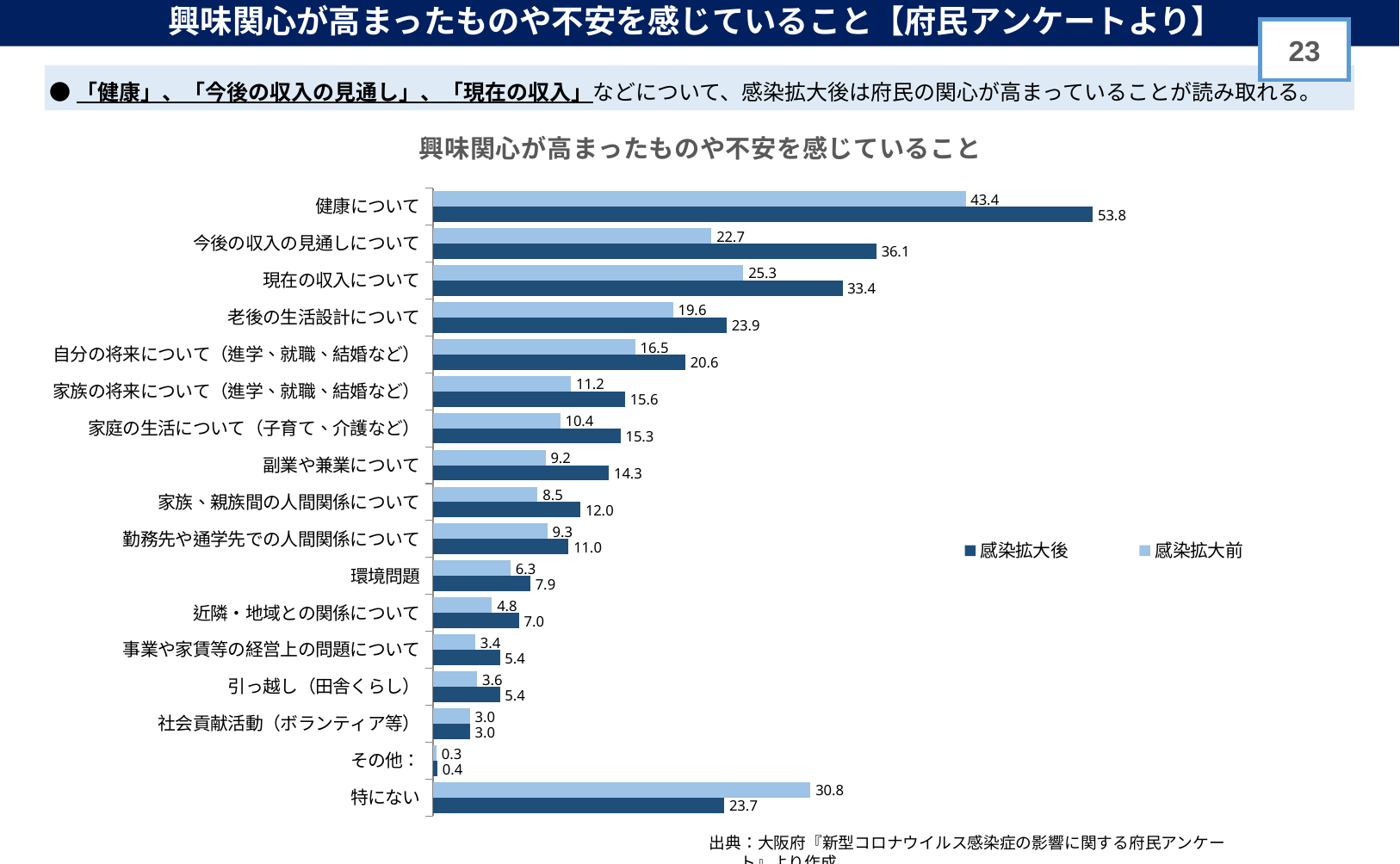
How many series does the legend list? 2 Which category has the lowest value in the 感染拡大前 series? その他： For 特にない, which series has the larger value, 感染拡大後 or 感染拡大前? 感染拡大前 Which series is shown in the darker blue colour? 感染拡大後 What is the value for 今後の収入の見通しについて in the 感染拡大前 series? 22.7 What is the value for 特にない in the 感染拡大前 series? 30.8 How many categories are shown on the chart? 17 What is the difference between the 感染拡大後 and 感染拡大前 values for 健康について? 10.4 What kind of chart is shown on the slide? Bar chart Which category has the highest value in the 感染拡大後 series? 健康について What is the value for 健康について in the 感染拡大後 series? 53.8 What is the title of the chart? 興味関心が高まったものや不安を感じていること